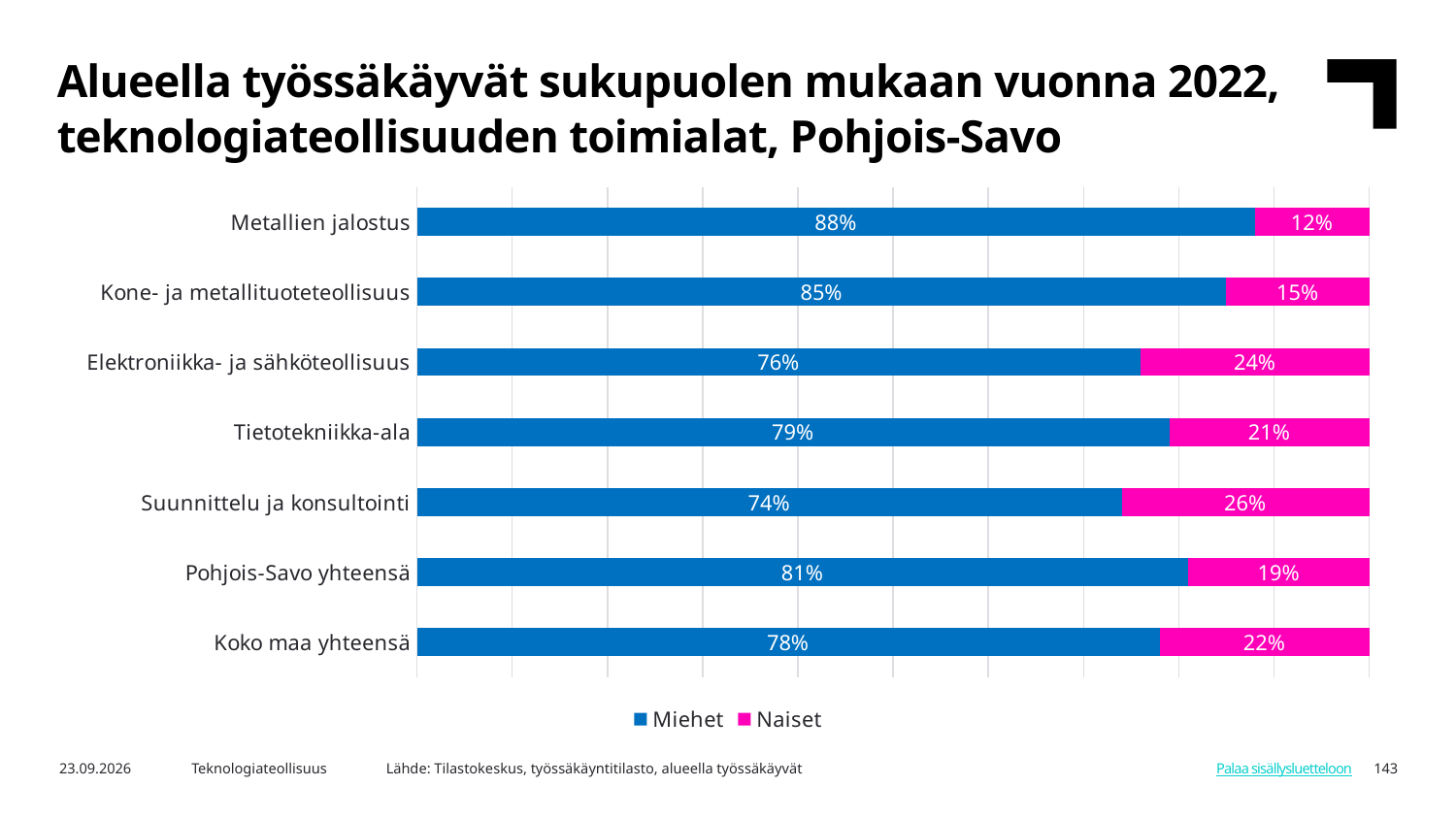
How many categories are shown on the chart? 7 What is the Naiset share for Suunnittelu ja konsultointi? 26% Which category has the lowest Miehet share? Suunnittelu ja konsultointi What is the Miehet share for Metallien jalostus? 88% Which category has the highest Miehet share? Metallien jalostus What kind of chart is shown on the slide? Stacked bar chart How many series does the legend list? 2 What is the difference between the Miehet share for Kone- ja metallituoteteollisuus and the Miehet share for Koko maa yhteensä? 7 percentage points What is the Naiset share for Pohjois-Savo yhteensä? 19% What are the two series named in the legend? Miehet and Naiset Which category has the highest Naiset share? Suunnittelu ja konsultointi Which is larger: the Naiset share for Elektroniikka- ja sähköteollisuus or the Naiset share for Tietotekniikka-ala? Elektroniikka- ja sähköteollisuus